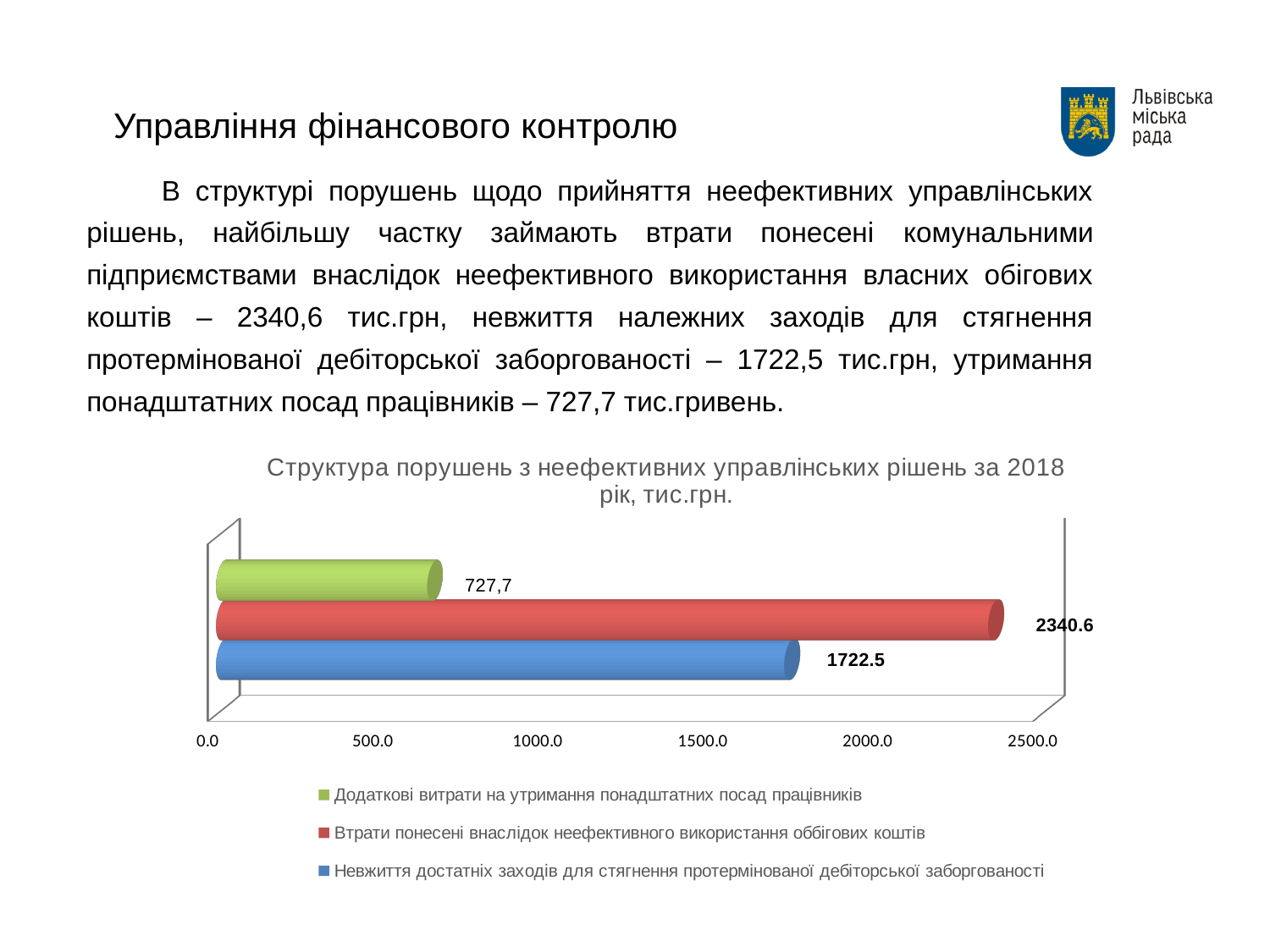
What value is shown for the series 'Додаткові витрати на утримання понадштатних посад працівників'? 727,7 What is the title of the chart? Структура порушень з неефективних управлінських рішень за 2018 рік, тис.грн. Which series has the highest value in the chart? Втрати понесені внаслідок неефективного використання оббігових коштів What colour is the bar for 'Додаткові витрати на утримання понадштатних посад працівників'? green Which is larger: the value for 'Невжиття достатніх заходів для стягнення протермінованої дебіторської заборгованості' or the value for 'Додаткові витрати на утримання понадштатних посад працівників'? Невжиття достатніх заходів для стягнення протермінованої дебіторської заборгованості What kind of chart is shown on the slide? bar chart What value is shown for the series 'Втрати понесені внаслідок неефективного використання оббігових коштів'? 2340.6 What is the difference between the value for 'Втрати понесені внаслідок неефективного використання оббігових коштів' and the value for 'Невжиття достатніх заходів для стягнення протермінованої дебіторської заборгованості'? 618.1 What value is shown for the series 'Невжиття достатніх заходів для стягнення протермінованої дебіторської заборгованості'? 1722.5 Which series has the lowest value in the chart? Додаткові витрати на утримання понадштатних посад працівників Is the value for 'Втрати понесені внаслідок неефективного використання оббігових коштів' greater or less than 2000.0? greater How many series does the legend list? 3